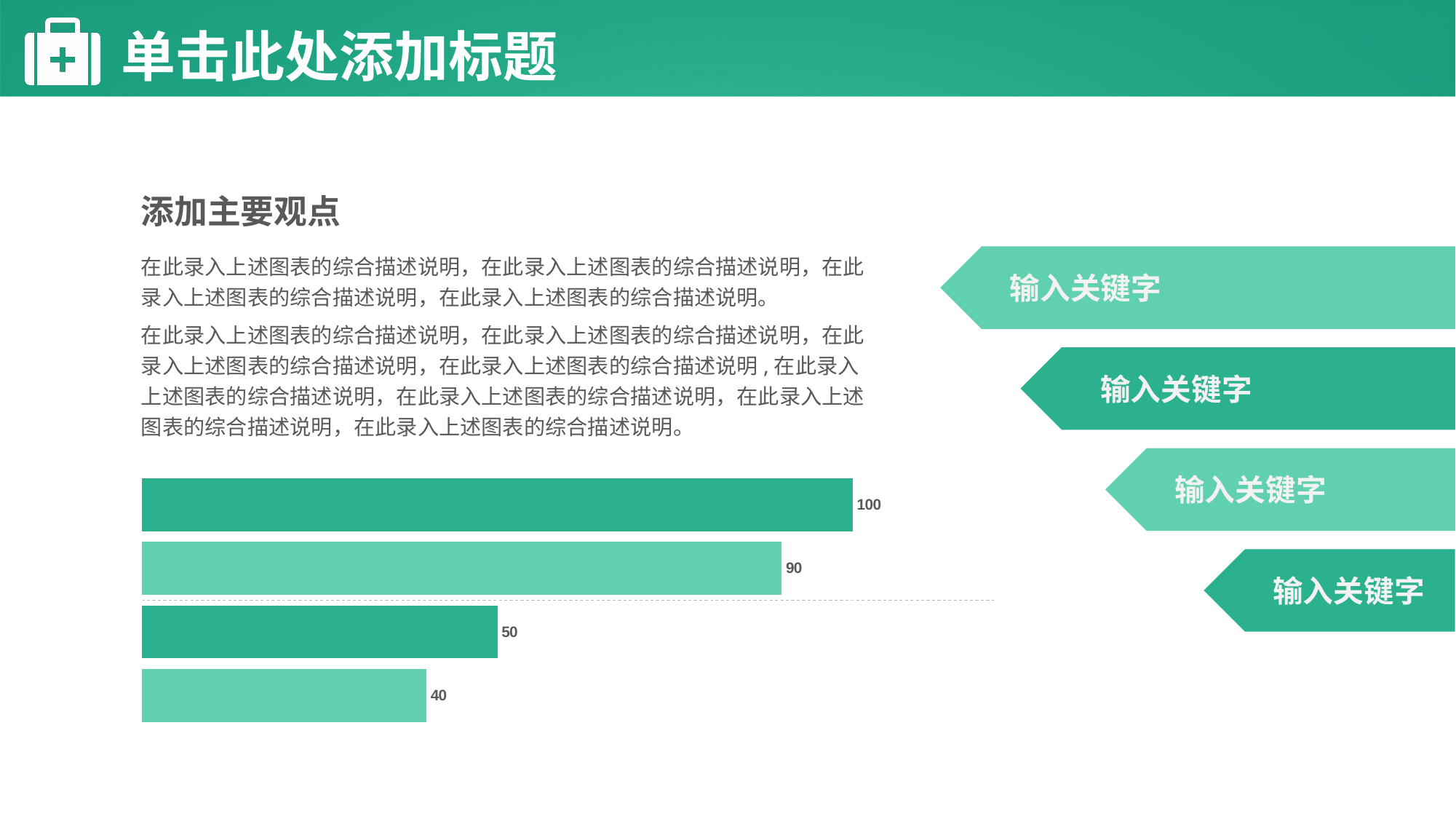
How many bars does the chart have? 4 What kind of chart is shown on the slide? bar chart Which bar has the highest value? the top bar What is the difference between the top bar and the bottom bar? 60 What is the value of the top bar in the chart? 100 What is the difference between the second bar and the third bar from the top? 40 Do the bar values increase or decrease from the top bar to the bottom bar? decrease What is the value of the bottom bar in the chart? 40 What is the value of the third bar from the top? 50 Which bar has the lowest value? the bottom bar Which is larger, the second bar from the top or the third bar from the top? the second bar from the top What is the value of the second bar from the top? 90